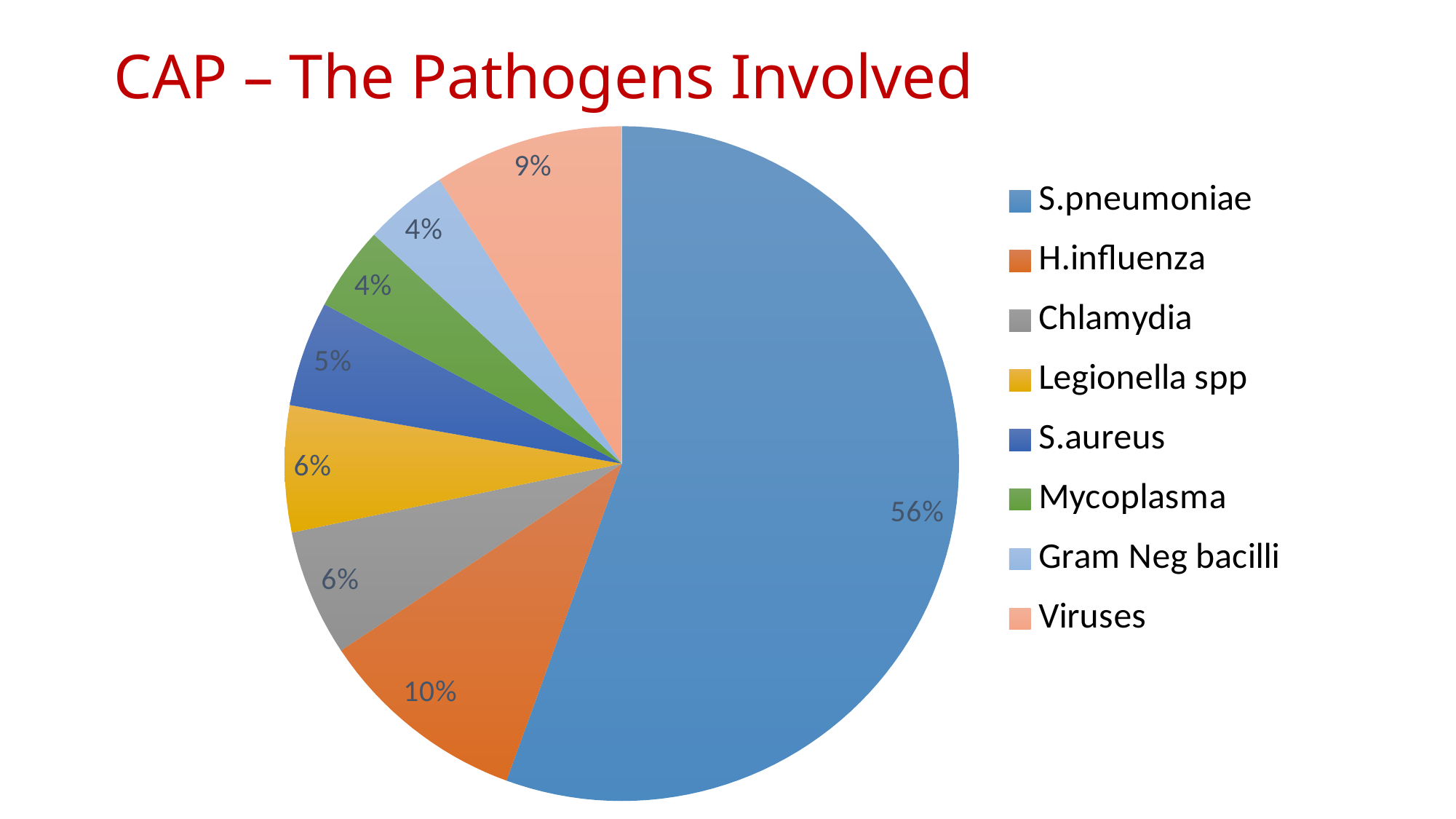
Which pathogen has the largest slice of the pie? S.pneumoniae What share of the pie does H.influenza account for? 10% What share of the pie does S.pneumoniae account for? 56% How many pathogen categories are shown in the pie chart? 8 Which is larger, the share for H.influenza or the share for Viruses? H.influenza What is the difference in percentage points between Viruses and S.aureus? 4 What share of the pie does Viruses account for? 9% What is the difference in percentage points between S.pneumoniae and H.influenza? 46 What is the title of the slide? CAP – The Pathogens Involved What share of the pie does Legionella spp account for? 6% What kind of chart is shown on the slide? Pie chart